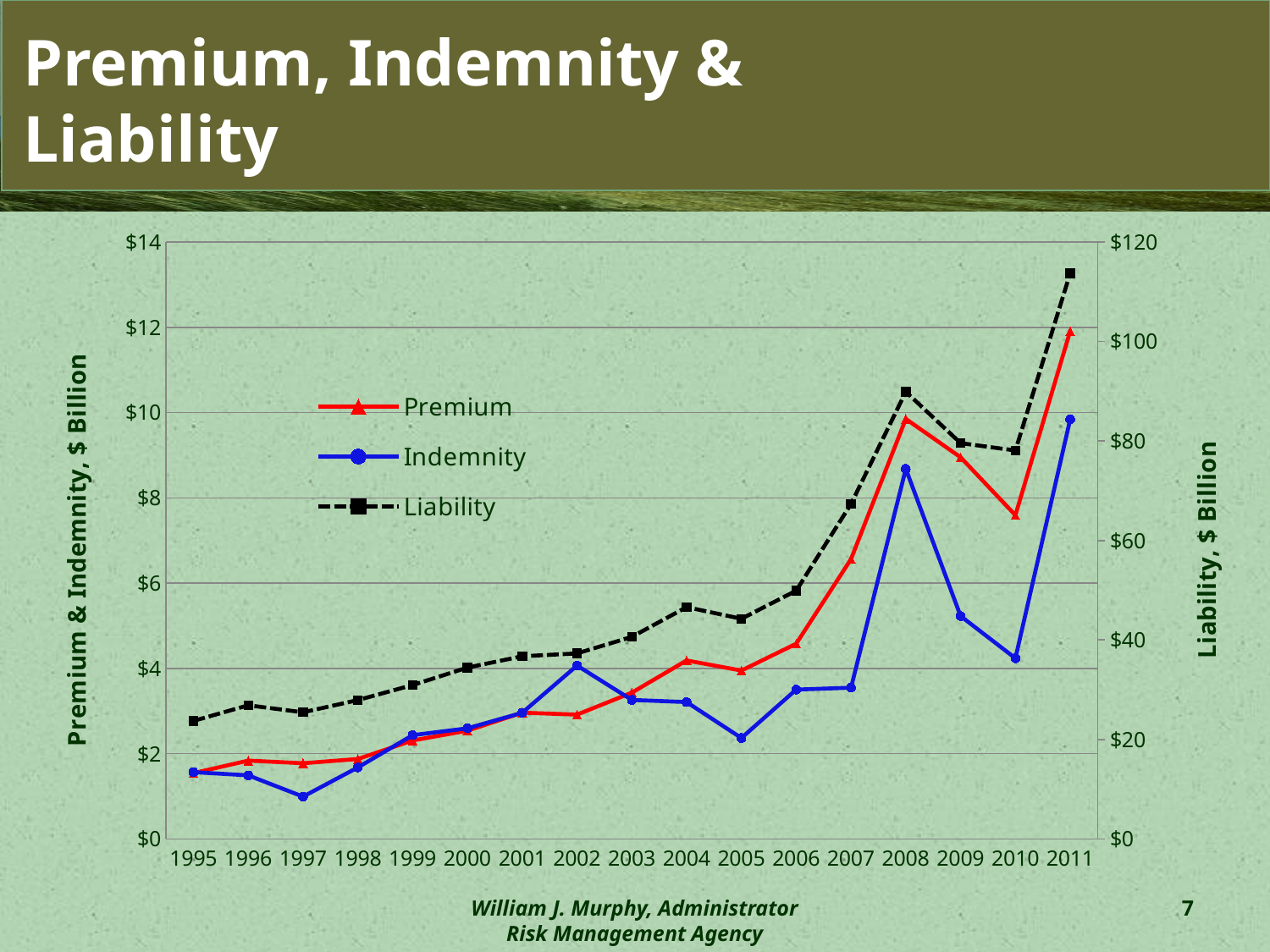
What kind of chart is shown on the slide? line chart In which year does the Indemnity series reach its lowest value? 1997 Is the Indemnity value for 2009 greater or less than $6? less How many years are plotted along the x axis? 17 In which year does the Premium series reach its highest value? 2011 In 2002, which is larger, Premium or Indemnity? Indemnity Does the Liability series generally rise or fall from 1995 to 2011? rise Is the Liability value for 2011 greater or less than $100? greater How many series does the legend list? 3 Is the Premium value for 2008 greater or less than $8? greater In which year is Liability at its lowest? 1995 Which series is drawn with a dashed line? Liability